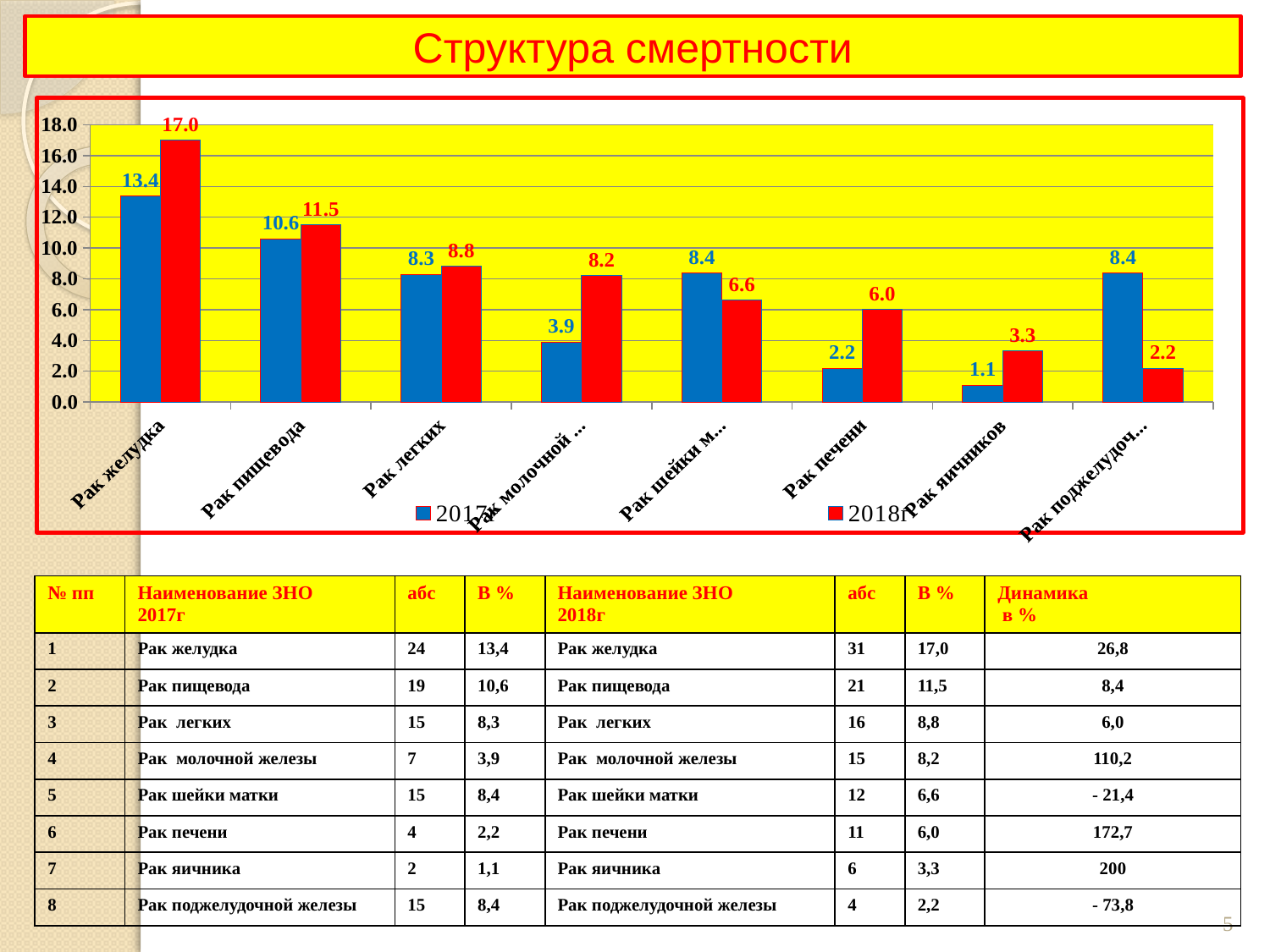
Which category has the lowest 2017г value? Рак яичников What kind of chart is shown on the slide? bar chart How many series does the chart legend list? 2 Is the 2018г value for Рак пищевода greater or less than 10.0? greater How many categories are shown on the x axis of the chart? 8 For Рак легких, which series has the larger value, 2017г or 2018г? 2018г What is the 2017г value for Рак яичников? 1.1 What is the difference between the 2018г and 2017г values for Рак желудка? 3.6 What is the 2017г value for Рак желудка? 13.4 Which category has the highest 2018г value? Рак желудка What is the difference between the 2018г and 2017г values for Рак печени? 3.8 What is the 2018г value for Рак печени? 6.0